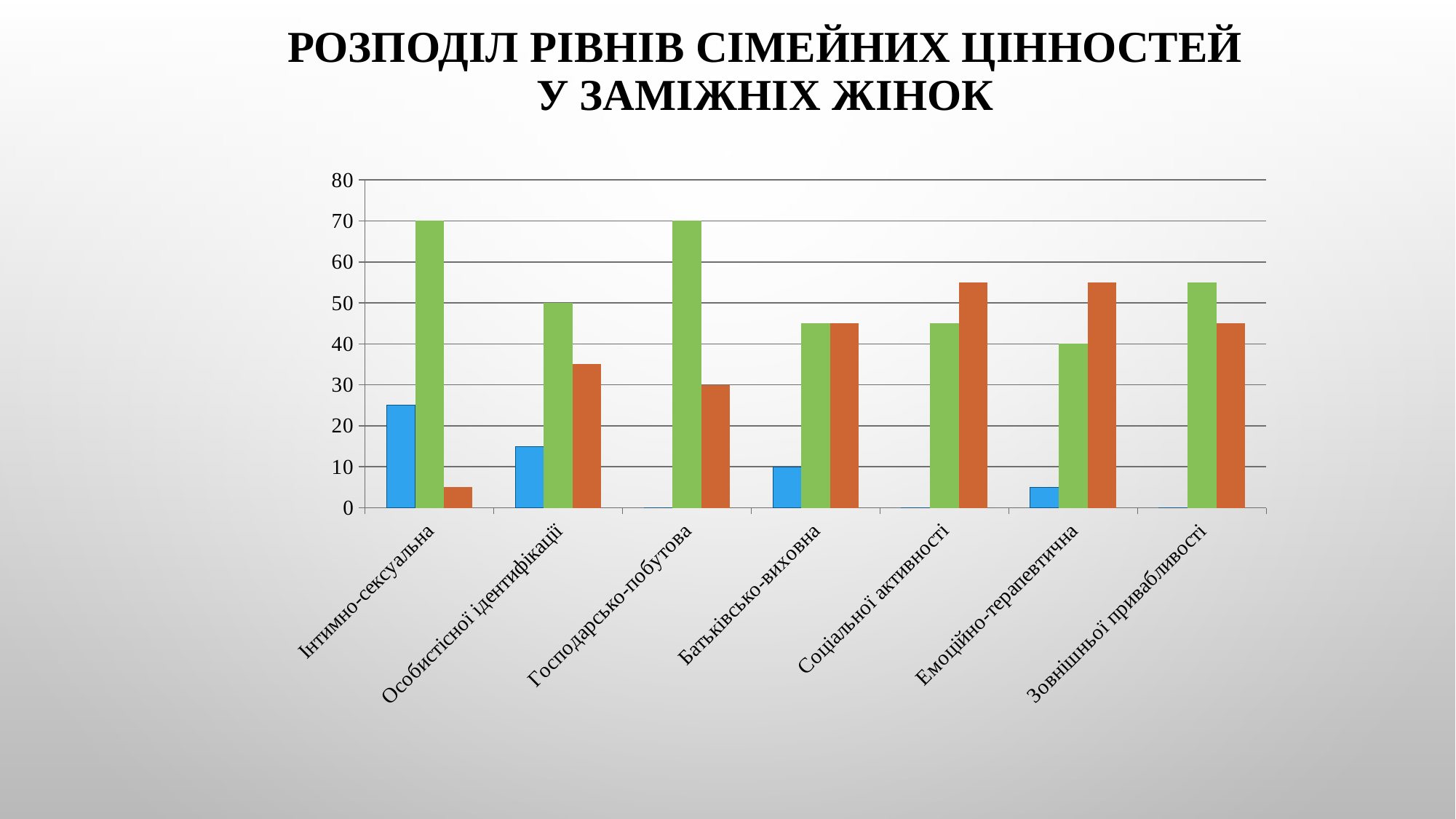
Is the value of the orange bar for Соціальної активності greater or less than 50? greater Which category has the highest blue bar? Інтимно-сексуальна What is the value of the green bar for Емоційно-терапевтична? 40 What is the value of the orange bar for Господарсько-побутова? 30 How many categories are shown on the x axis of the chart? 7 What is the value of the green bar for Особистісної ідентифікації? 50 What is the value of the blue bar for Батьківсько-виховна? 10 What is the value of the green bar for Інтимно-сексуальна? 70 For Інтимно-сексуальна, which is larger: the green bar or the orange bar? the green bar What kind of chart is shown on the slide? bar chart What is the difference between the green bar and the orange bar for Господарсько-побутова? 40 Which category has the lowest green bar? Емоційно-терапевтична